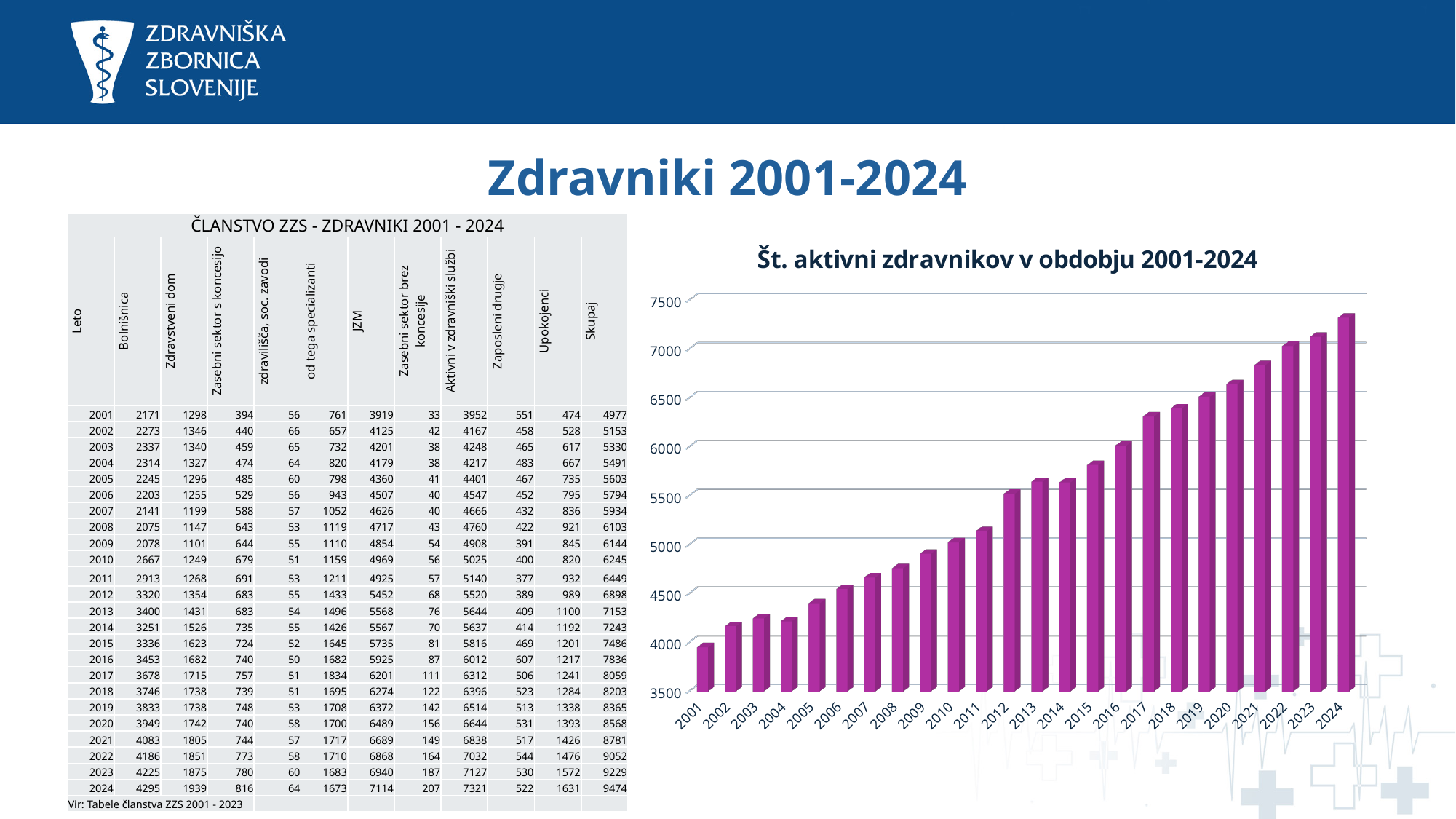
Is the value for 2024 greater or less than 7000? greater Do the values in the chart generally rise or fall from 2001 to 2024? rise Which year has the highest bar in the chart? 2024 Which year has the larger value, 2015 or 2012? 2015 What is the title of the chart? Št. aktivni zdravnikov v obdobju 2001-2024 Which year has the lowest bar in the chart? 2001 Is the value for 2005 greater or less than 4500? less What colour are the bars in the chart? purple (magenta) What kind of chart is shown on the slide? bar chart Is the value for 2008 greater or less than 4500? greater How many years (bars) are plotted in the chart? 24